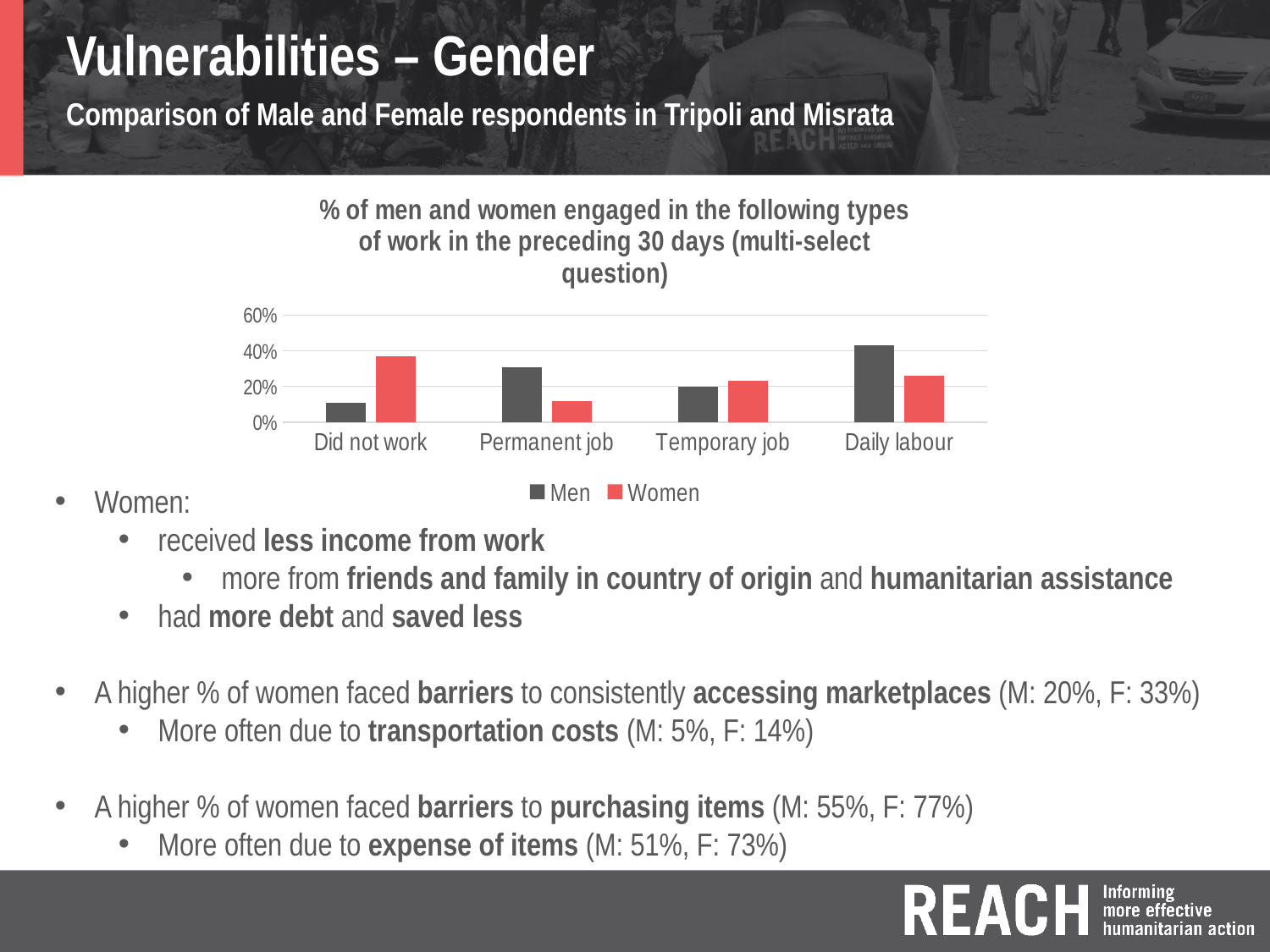
Is the value for Men in 'Did not work' greater or less than 20%? less What kind of chart is shown on the slide? bar chart Which two series are listed in the chart's legend? Men and Women Which category has the lowest value for Men? Did not work For 'Did not work', which is larger: the value for Men or for Women? Women Which category has the highest value for Women? Did not work Which category has the lowest value for Women? Permanent job Which type of work has the highest value for Men? Daily labour Is the value for Men in 'Daily labour' greater or less than 40%? greater How many types of work categories are shown on the x axis of the chart? 4 For 'Permanent job', which is larger: the value for Men or for Women? Men How many series does the chart's legend list? 2